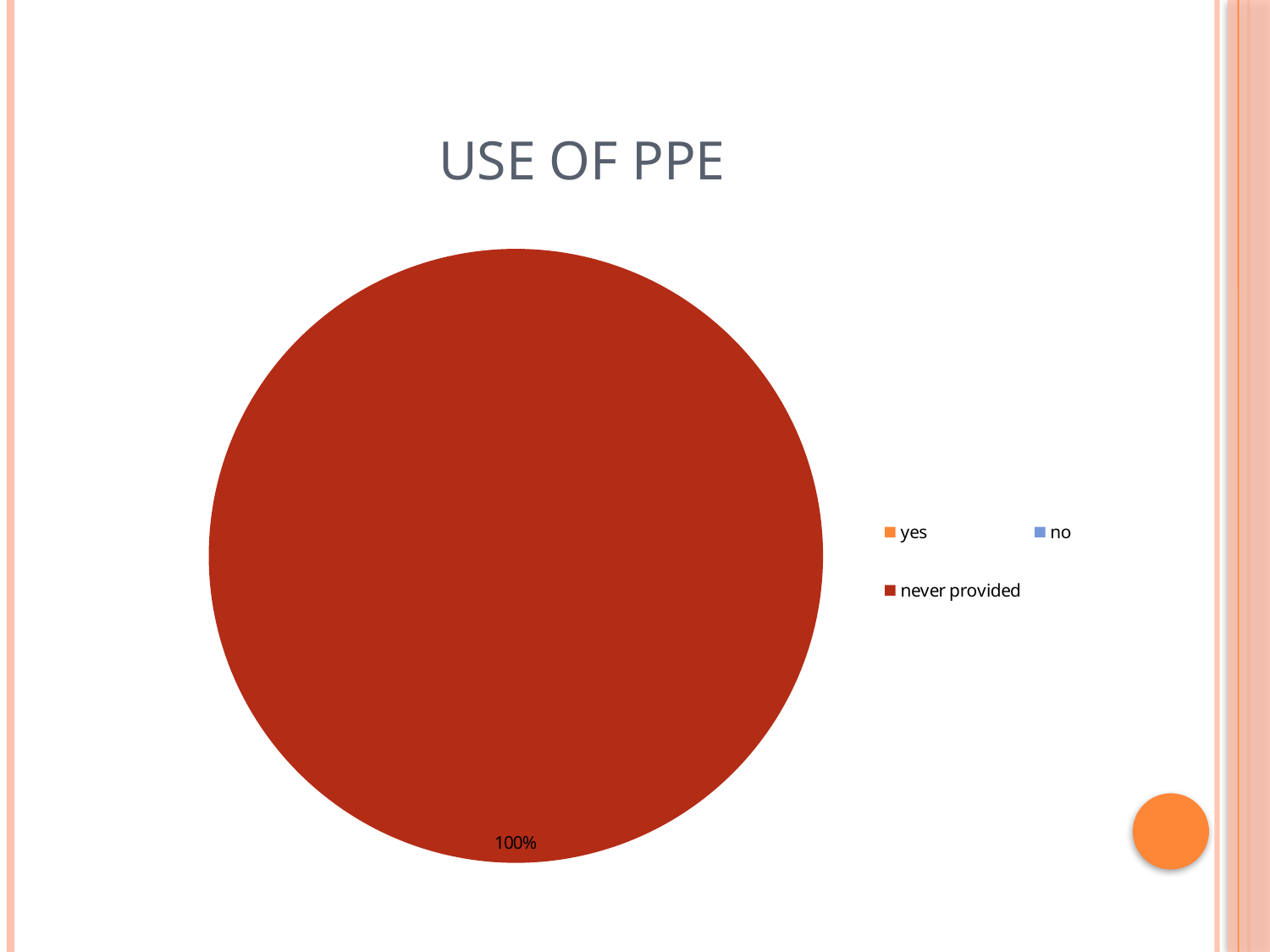
Which category has the largest share of the pie? never provided What is the title of the chart? USE OF PPE Which is larger, the share for 'never provided' or the share for 'yes'? never provided Which legend entry is shown in dark red? never provided What share of the pie does the 'never provided' slice take? 100% What kind of chart is shown on the slide? pie chart Is the share for 'never provided' greater or less than 50%? greater How many entries does the legend list? 3 What is the value printed on the pie chart? 100%